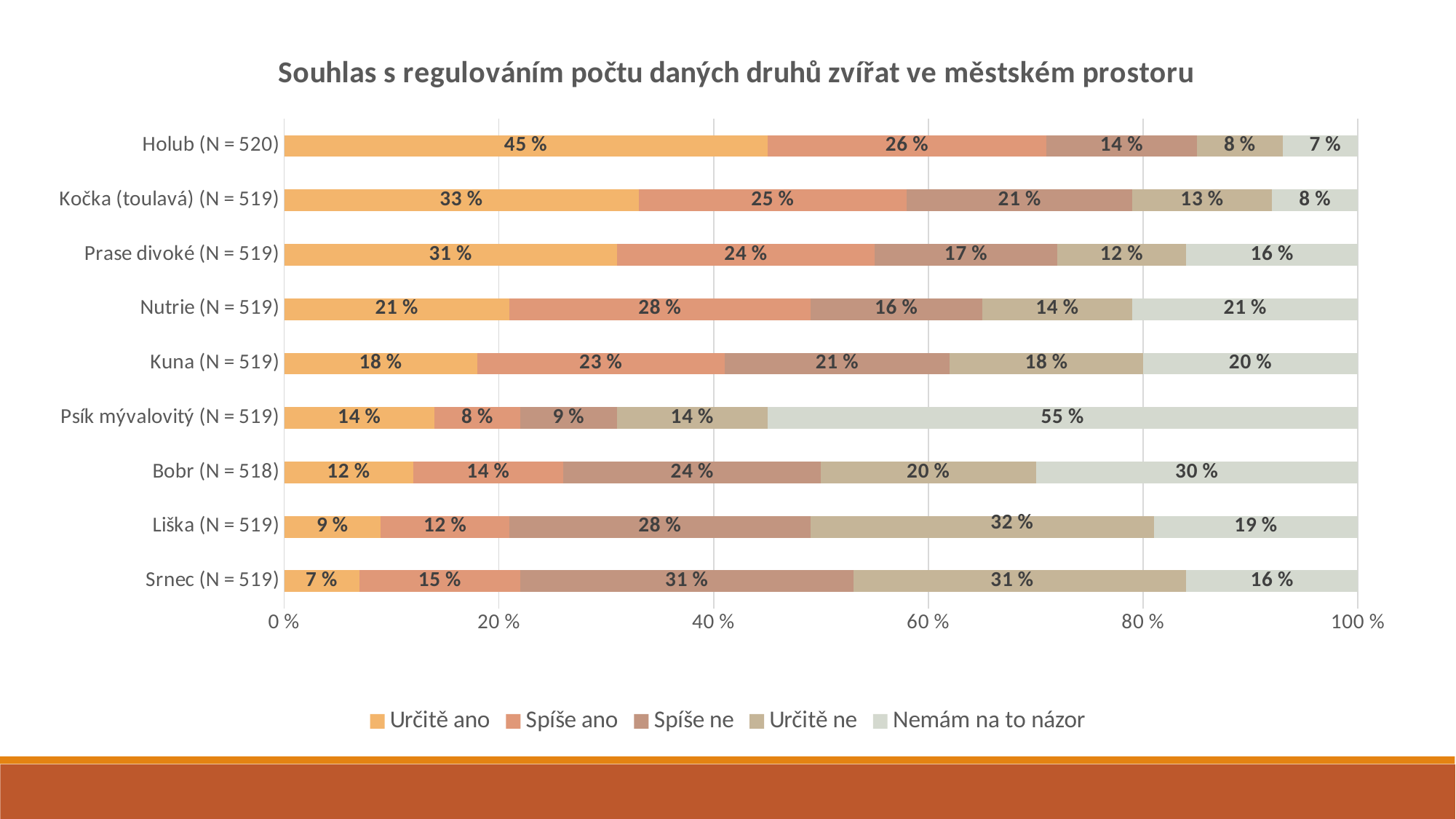
How many series does the legend list? 5 How many categories (animal species) are shown on the chart? 9 Which has the larger "Spíše ne" value, Bobr (N = 518) or Liška (N = 519)? Liška (N = 519) Which category has the highest "Určitě ano" value? Holub (N = 520) What is the value of "Určitě ne" for Liška (N = 519)? 32 % What is the value of "Určitě ano" for Holub (N = 520)? 45 % What is the difference between the "Určitě ano" values for Holub (N = 520) and Kočka (toulavá) (N = 519)? 12 % What is the value of "Nemám na to názor" for Psík mývalovitý (N = 519)? 55 % What is the total of the stacked bar for Nutrie (N = 519)? 100 % What is the title of the chart? Souhlas s regulováním počtu daných druhů zvířat ve městském prostoru What kind of chart is shown on the slide? Stacked bar chart Which category has the lowest "Určitě ano" value? Srnec (N = 519)